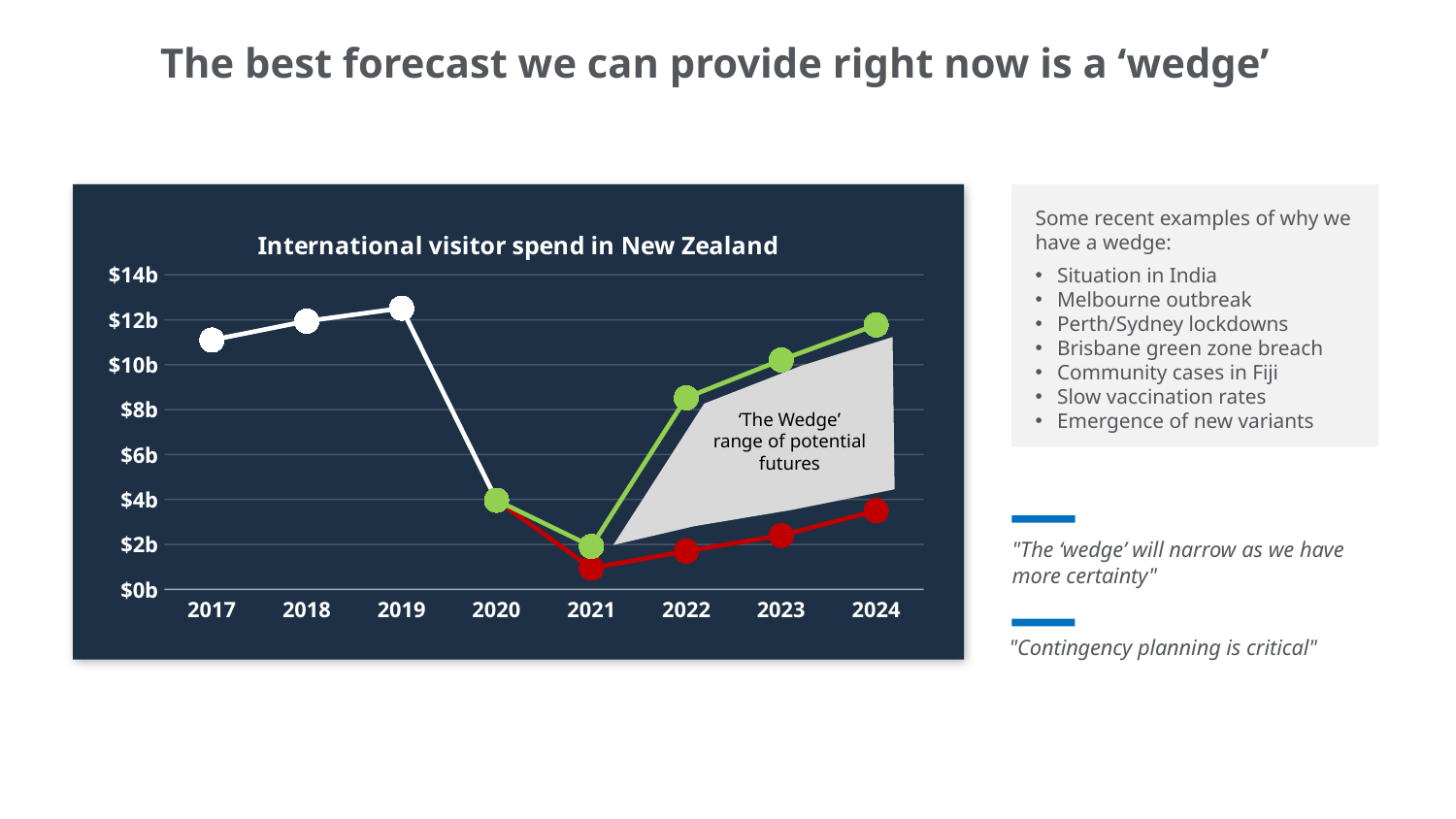
Is the value of the green line in 2024 greater or less than $10b? greater Is the value of the red line in 2021 greater or less than $2b? less What kind of chart is shown on the slide? line chart In 2024, which line is higher, the green line or the red line? green line Is the value of the red line in 2024 greater or less than $6b? less How many years are shown on the x axis of the chart? 8 What is the title of the chart? International visitor spend in New Zealand Which year has the highest value on the chart? 2019 Does the white line rise or fall from 2017 to 2019? rise